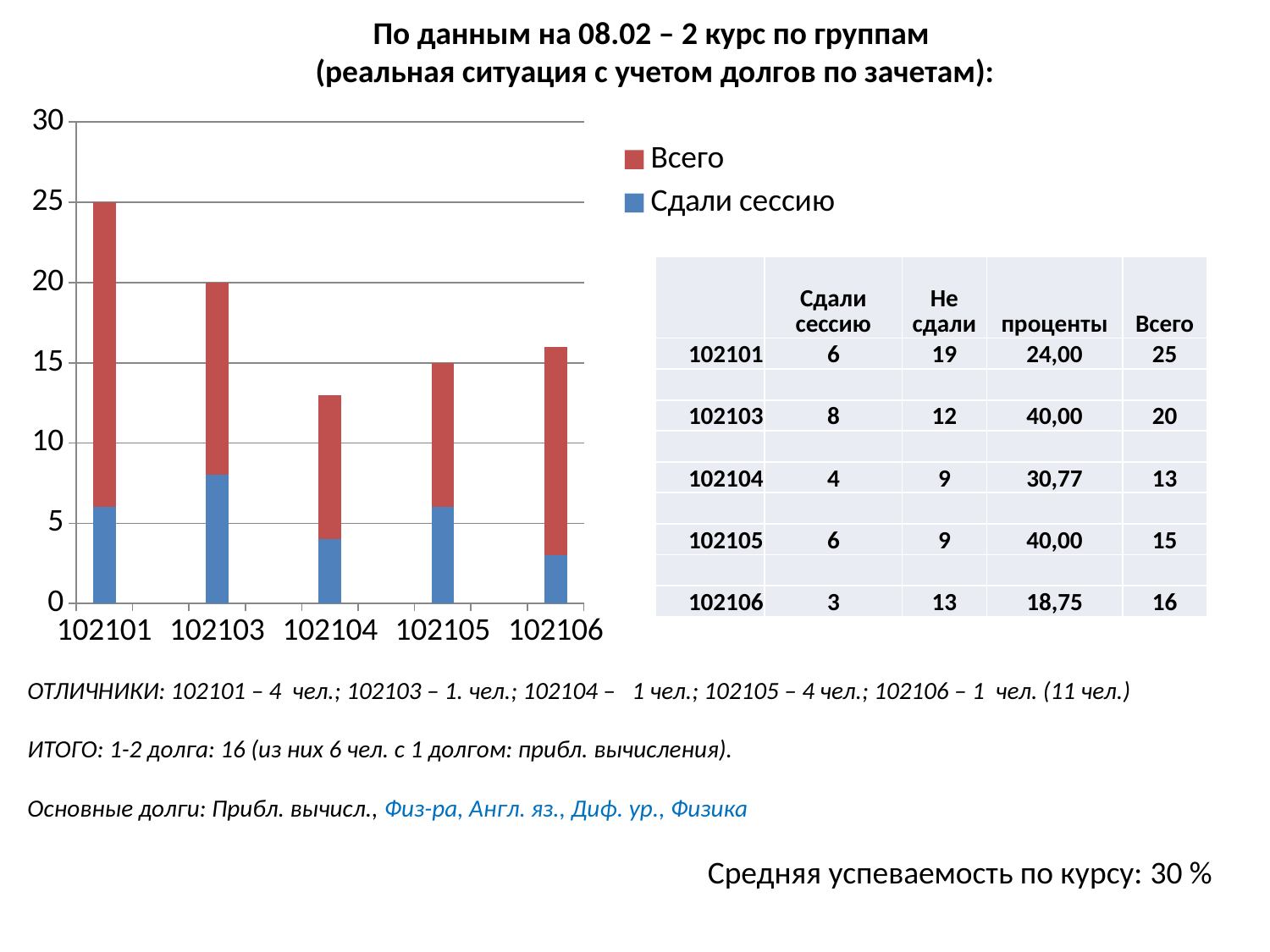
Is the Всего value for group 102106 greater or less than 20? less What is the difference between Всего for 102101 and Всего for 102103? 5 How many series does the chart legend list? 2 What is the value of Сдали сессию for group 102103? 8 What type of chart is shown on the slide? bar chart Which group has the highest Всего value? 102101 How many groups are shown on the x axis of the chart? 5 What is the value of Всего for group 102104? 13 What is the value of Всего for group 102101? 25 Which group has the lowest Сдали сессию value? 102106 Which is larger: Сдали сессию for 102103 or Сдали сессию for 102105? 102103 What are the two series named in the chart legend? Всего, Сдали сессию